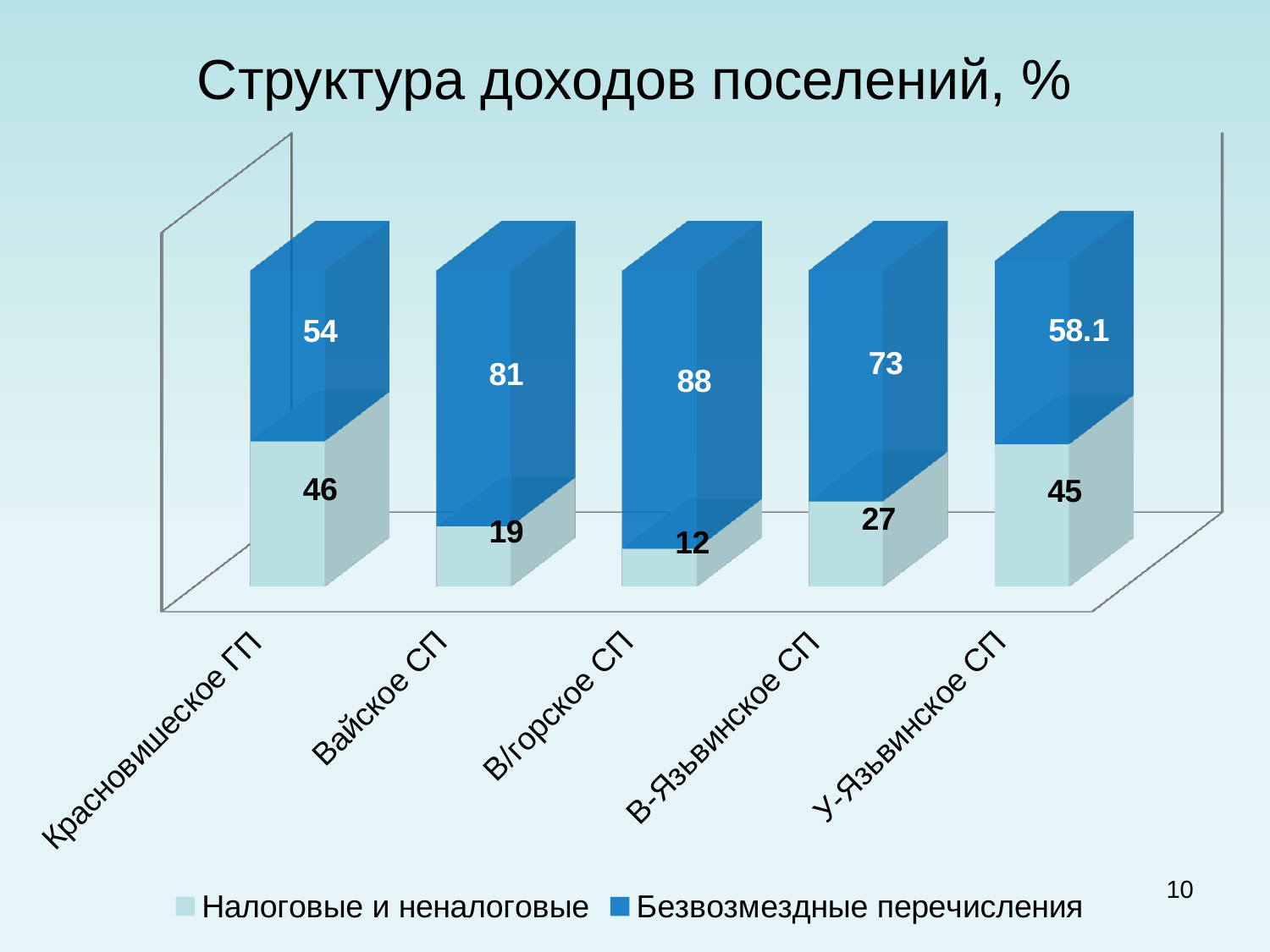
What is the value of Налоговые и неналоговые for Красновишерское ГП? 46 What is the value of Безвозмездные перечисления for Вайское СП? 81 How many categories are shown on the x axis? 5 What kind of chart is shown on the slide? Stacked bar chart Which category has the lowest value for Налоговые и неналоговые? В/горское СП Which is larger: the Налоговые и неналоговые value for Вайское СП or for В-Язьвинское СП? В-Язьвинское СП What is the value of Налоговые и неналоговые for В-Язьвинское СП? 27 How many series does the legend list? 2 What is the total of the stacked bar for Вайское СП? 100 What is the value of Безвозмездные перечисления for У-Язьвинское СП? 58.1 What is the difference between the Безвозмездные перечисления values for В/горское СП and Красновишерское ГП? 34 Which category has the highest value for Безвозмездные перечисления? В/горское СП